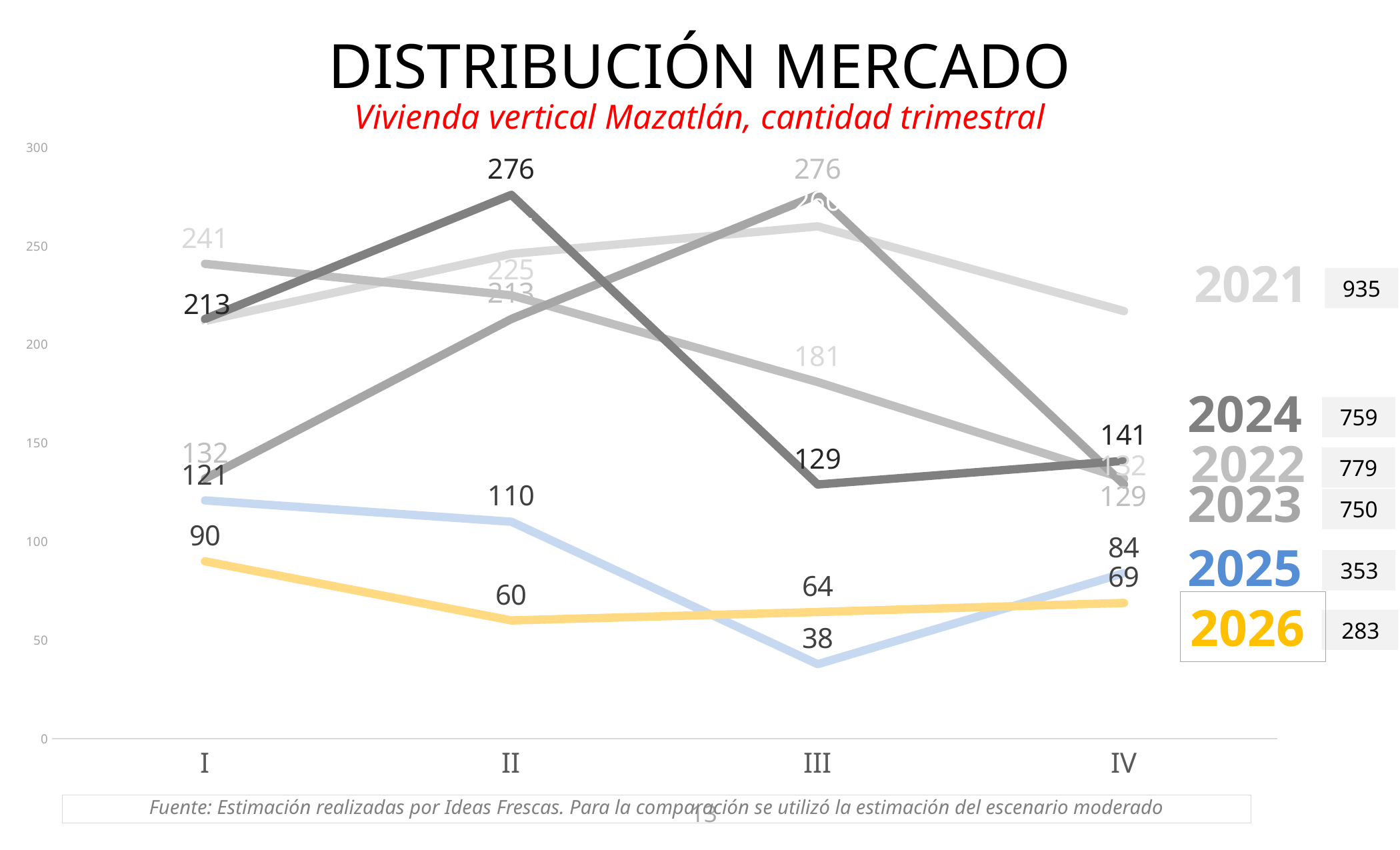
What is the difference between the 2024 values in quarter II and quarter III? 147 What kind of chart is shown on the slide? line chart What is the value for 2026 in quarter I? 90 In which quarter does the 2024 series reach its highest value? II In quarter IV, which is larger: the value for 2025 or the value for 2026? 2025 What is the value for 2025 in quarter III? 38 How many years (series) does the legend list? 6 Does the 2026 series rise or fall from quarter I to quarter II? fall How many quarters are shown on the x axis? 4 In which quarter does the 2025 series reach its lowest value? III What total is shown next to 2021 in the legend? 935 What is the value for 2024 in quarter II? 276